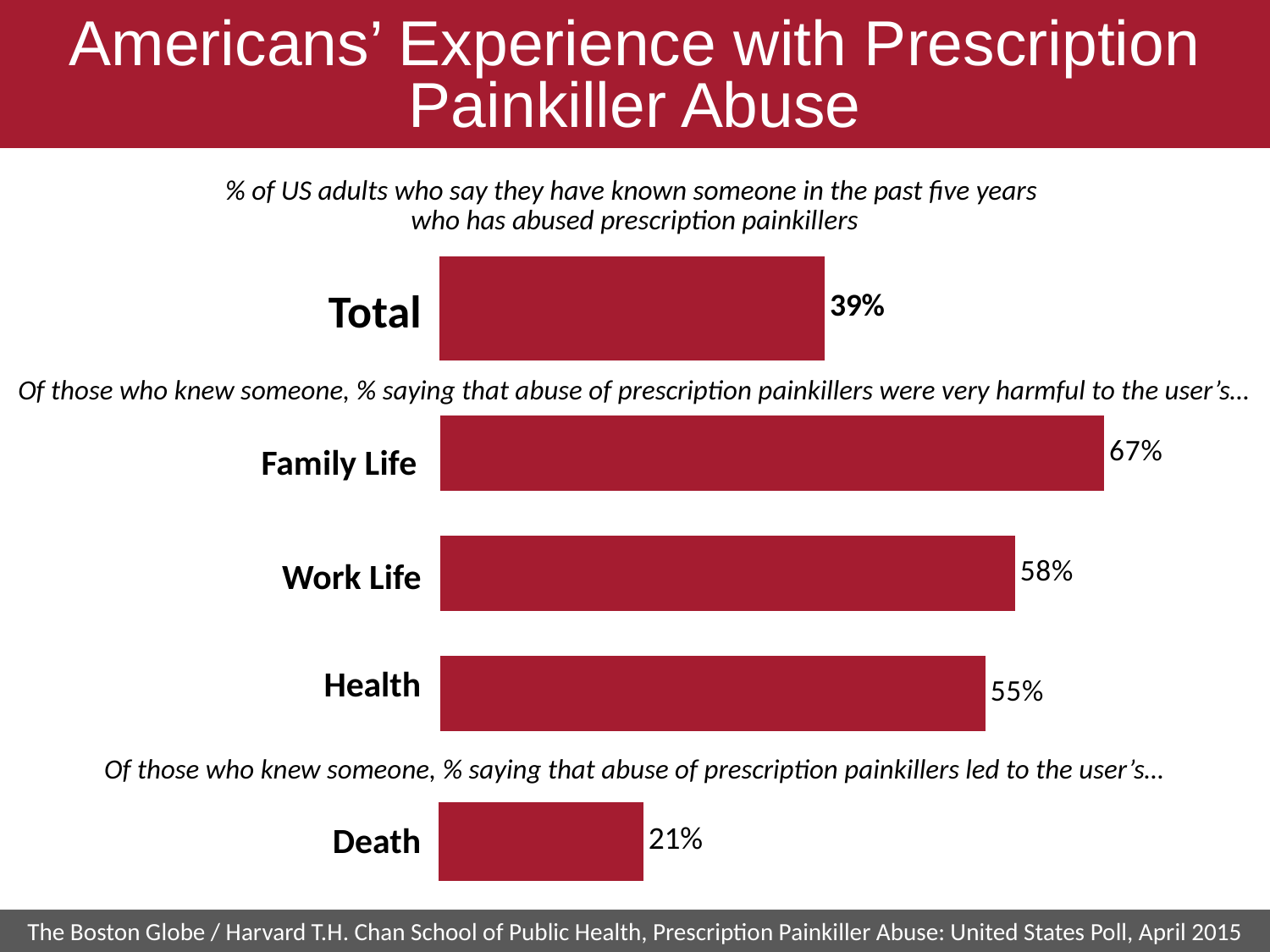
What is the title of the slide containing these charts? Americans' Experience with Prescription Painkiller Abuse In the chart about abuse being very harmful to the user's..., what is the value for Work Life? 58% In the chart '% of US adults who say they have known someone in the past five years who has abused prescription painkillers', what is the value for Total? 39% In the chart about abuse being very harmful to the user's..., which category has the lowest value? Health In the chart about abuse being very harmful to the user's..., which category has the highest value? Family Life In the chart about abuse leading to the user's..., what is the value for Death? 21% In the chart about abuse being very harmful to the user's..., what is the difference between Work Life and Health? 3% In the chart about abuse being very harmful to the user's..., how many categories are shown? 3 In the chart about abuse being very harmful to the user's..., what is the value for Health? 55% In the chart about abuse being very harmful to the user's..., what is the value for Family Life? 67% What kind of chart is used on this slide to show the percentages? Bar chart In the chart about abuse being very harmful to the user's..., what is the difference between Family Life and Work Life? 9%